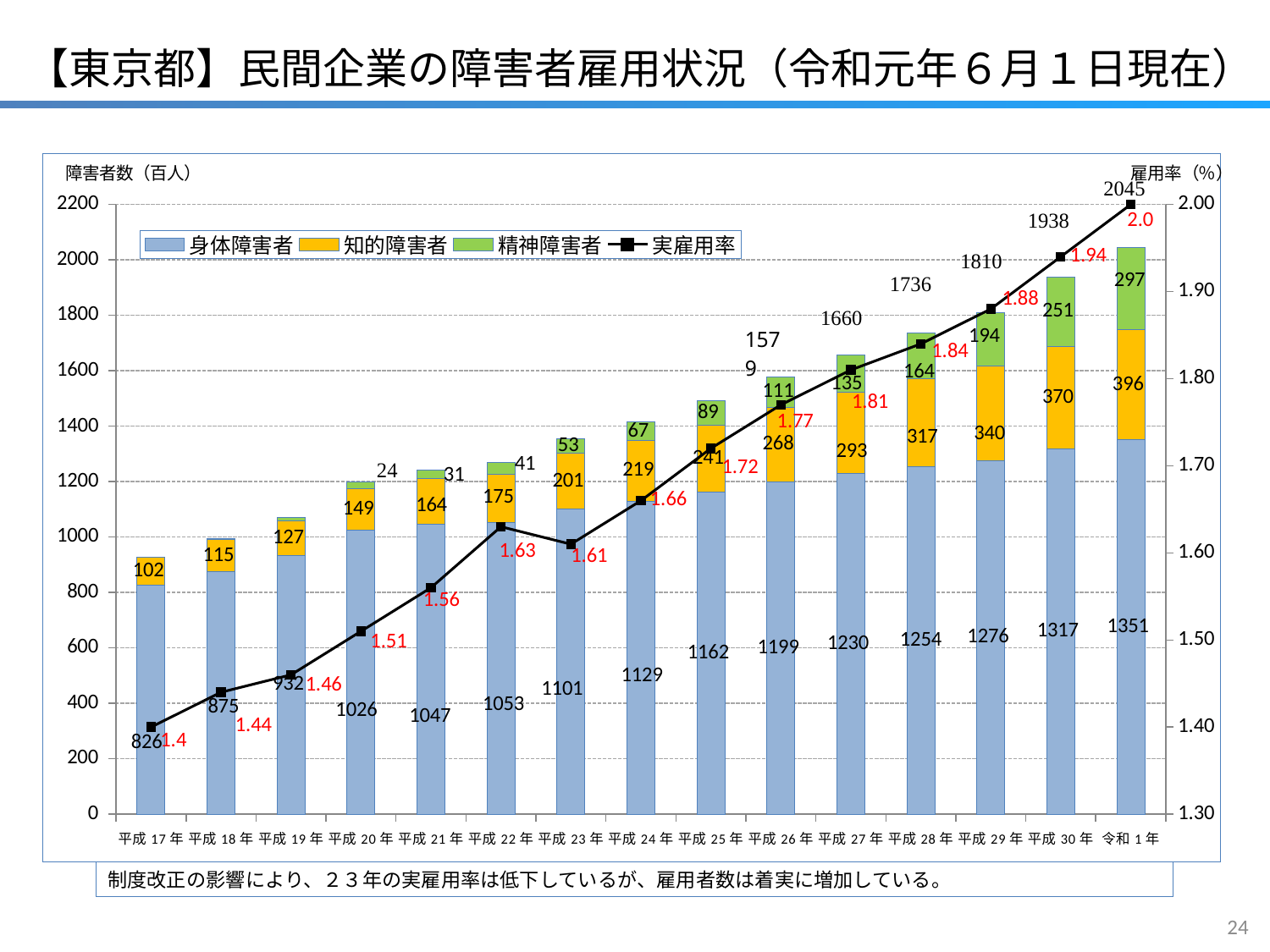
Which year has the highest 実雇用率 value? 令和1年 What kind of chart is this? Stacked bar chart with a line What is the 実雇用率 value for 平成23年? 1.61 What is the value for 精神障害者 in 平成30年? 251 Which year has the lowest 身体障害者 value? 平成17年 How many years are shown on the x axis? 15 What is the value for 身体障害者 in 令和1年? 1351 How many series does the legend list? 4 What is the total of the stacked bar for 平成27年 as labelled on the chart? 1660 What is the value for 知的障害者 in 平成25年? 241 What is the difference between the 知的障害者 values for 令和1年 and 平成30年? 26 Which is larger, the 精神障害者 value for 平成28年 or the 知的障害者 value for 平成20年? 精神障害者 for 平成28年